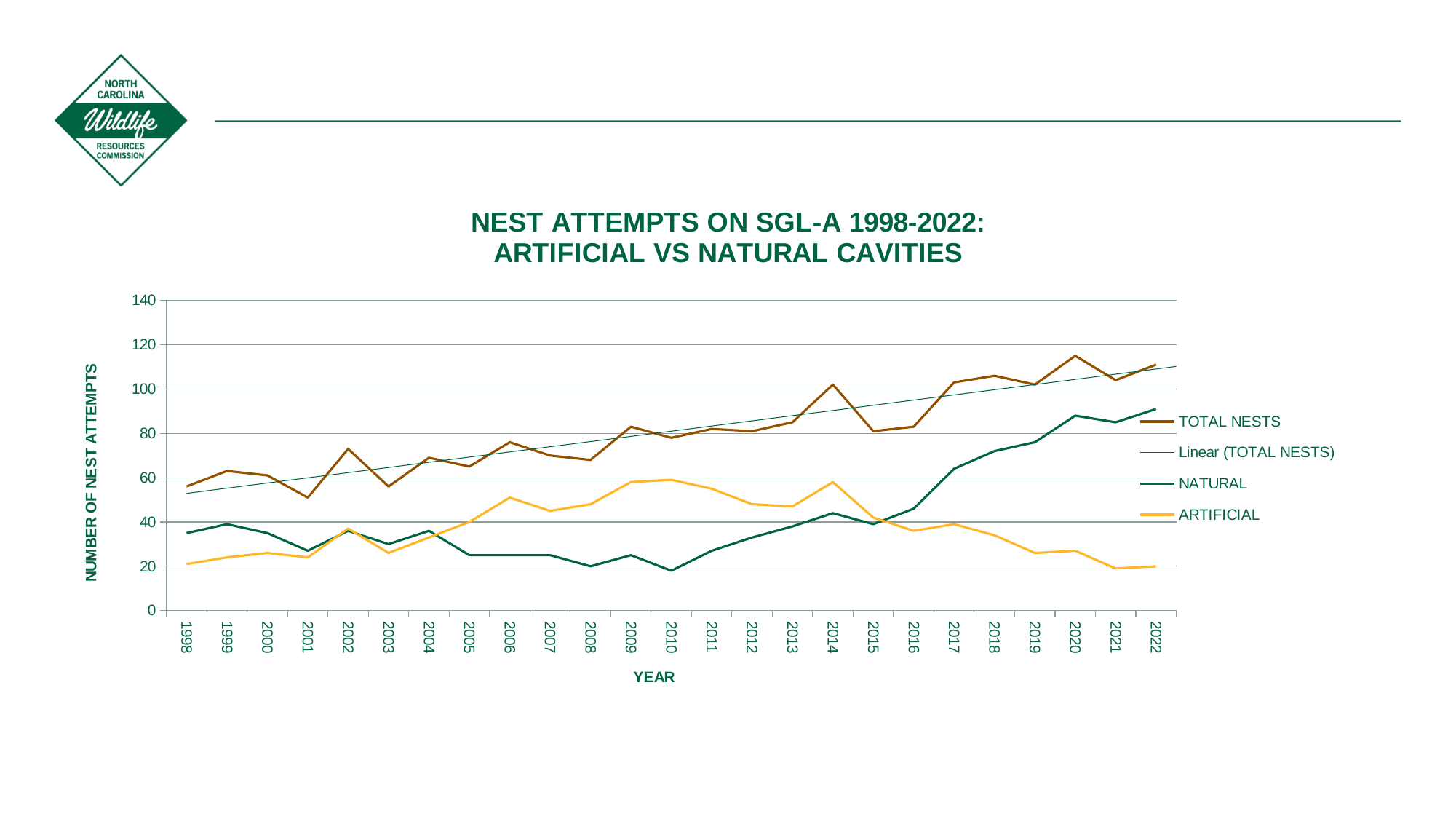
In which year is the TOTAL NESTS value lowest? 2001 In 2022, which is larger, the NATURAL value or the ARTIFICIAL value? NATURAL Is the NATURAL value for 2022 greater or less than 80? greater What kind of chart is shown on the slide? Line chart How many years are plotted along the x axis? 25 Does the TOTAL NESTS series generally rise or fall from 1998 to 2022? rise Is the TOTAL NESTS value for 2020 greater or less than 100? greater Is the TOTAL NESTS value for 2001 greater or less than 60? less In which year is the TOTAL NESTS value highest? 2020 What is the label on the y axis? NUMBER OF NEST ATTEMPTS How many series does the legend list? 4